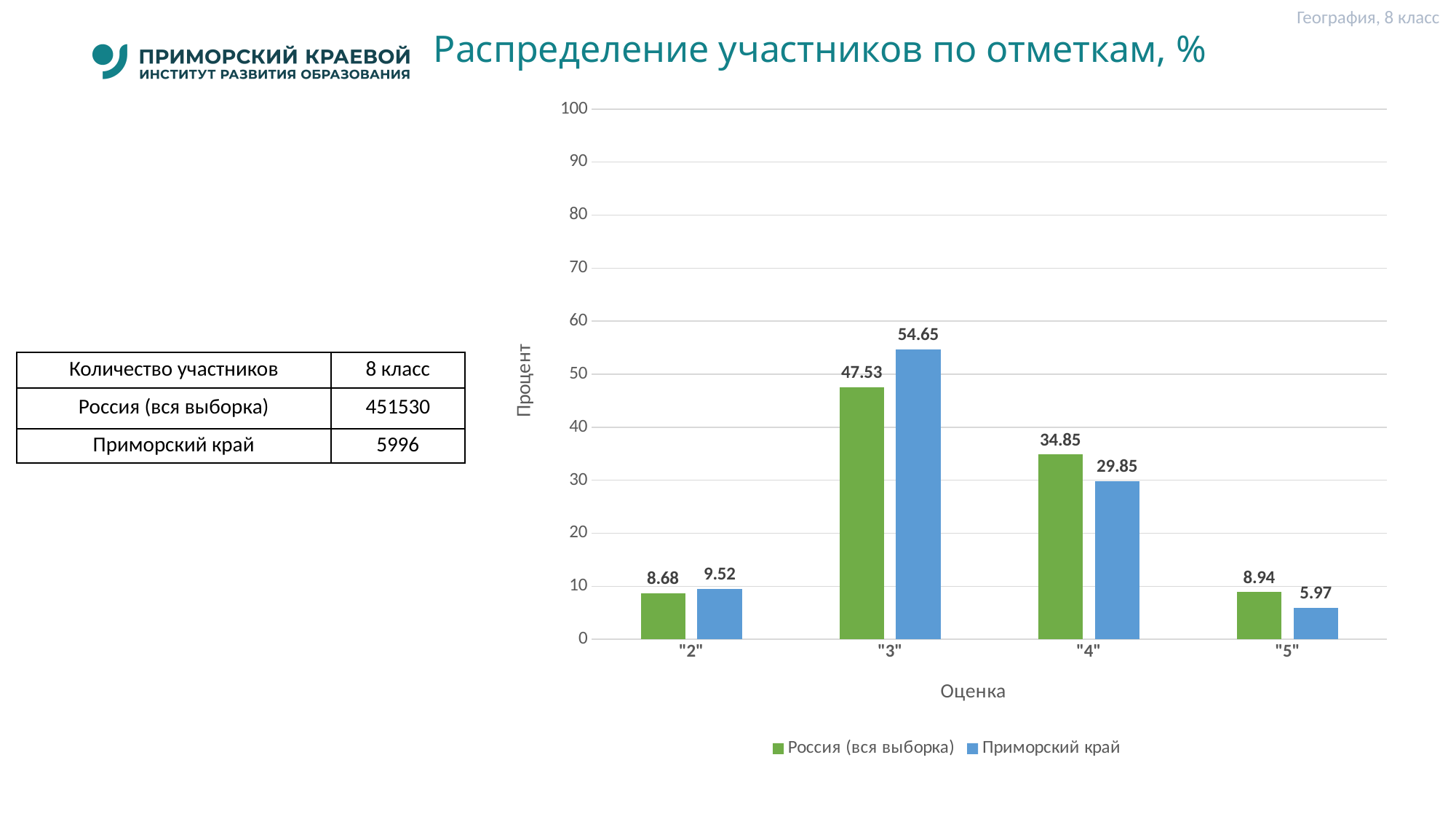
What is the value for Приморский край at grade "5"? 5.97 How many series does the legend list? 2 What is the value for Приморский край at grade "3"? 54.65 Is the value for Приморский край at grade "3" greater or less than 50? greater Which grade has the lowest value for Приморский край? "5" Which grade has the highest value for Россия (вся выборка)? "3" What is the label of the y axis? Процент What kind of chart is shown on the slide? bar chart Which is larger at grade "4": Россия (вся выборка) or Приморский край? Россия (вся выборка) What is the value for Россия (вся выборка) at grade "4"? 34.85 What is the difference between Приморский край and Россия (вся выборка) at grade "3"? 7.12 How many grade categories are shown on the x axis? 4